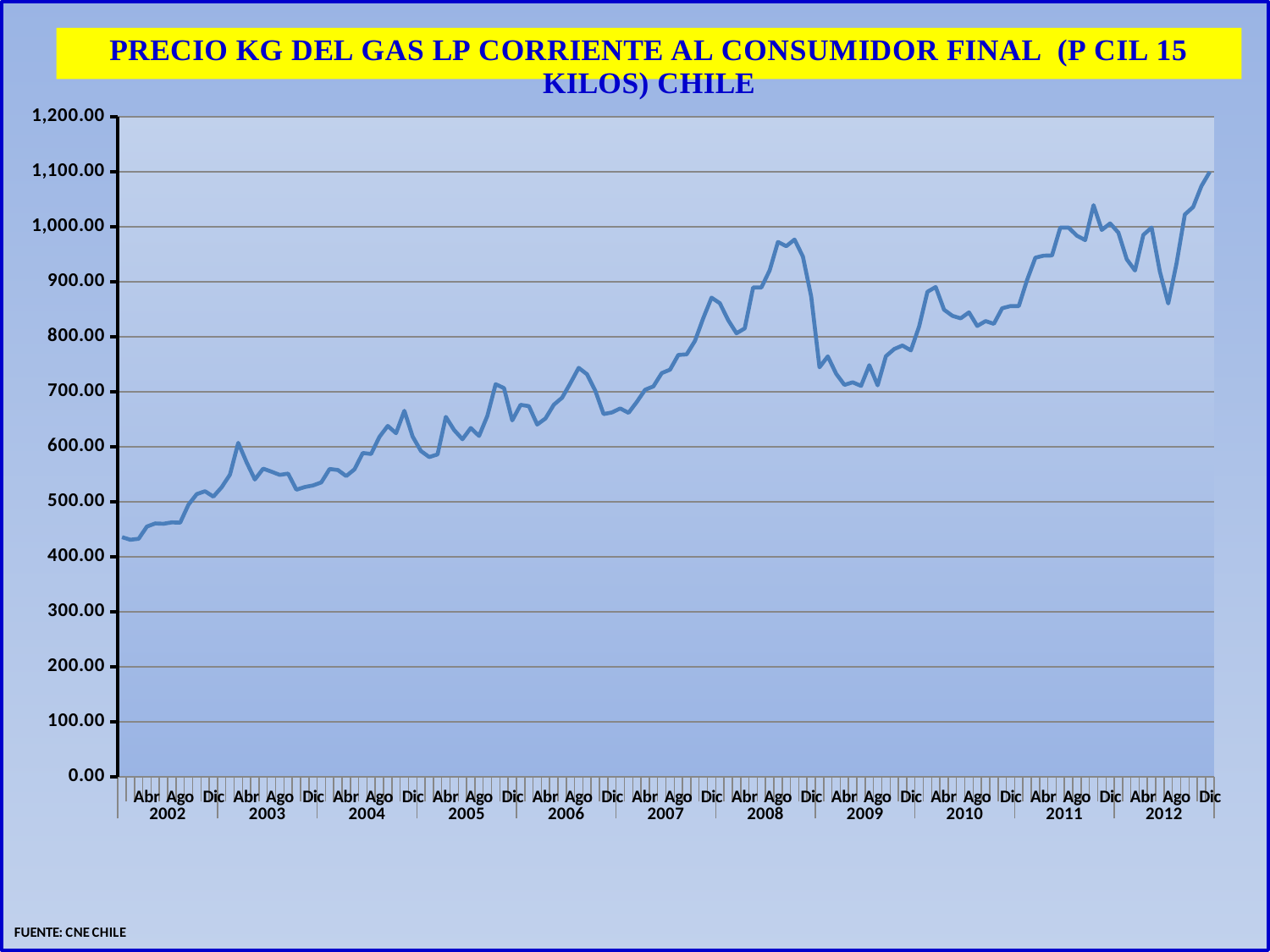
What kind of chart is shown on the slide? line chart What is the title of the chart? PRECIO KG DEL GAS LP CORRIENTE AL CONSUMIDOR FINAL (P CIL 15 KILOS) CHILE Is the value at Ago 2008 greater or less than 900.00? greater Is the value at Dic 2010 greater or less than 800.00? greater In which year does the line reach its highest point? 2012 Overall, does the price rise or fall from 2002 to 2012? rise How many years are labeled along the x axis? 11 Is the value at Dic 2012 greater or less than 1,000.00? greater Which is higher, the value at Ago 2008 or the value at Dic 2012? Dic 2012 What source is cited at the bottom of the slide? CNE CHILE